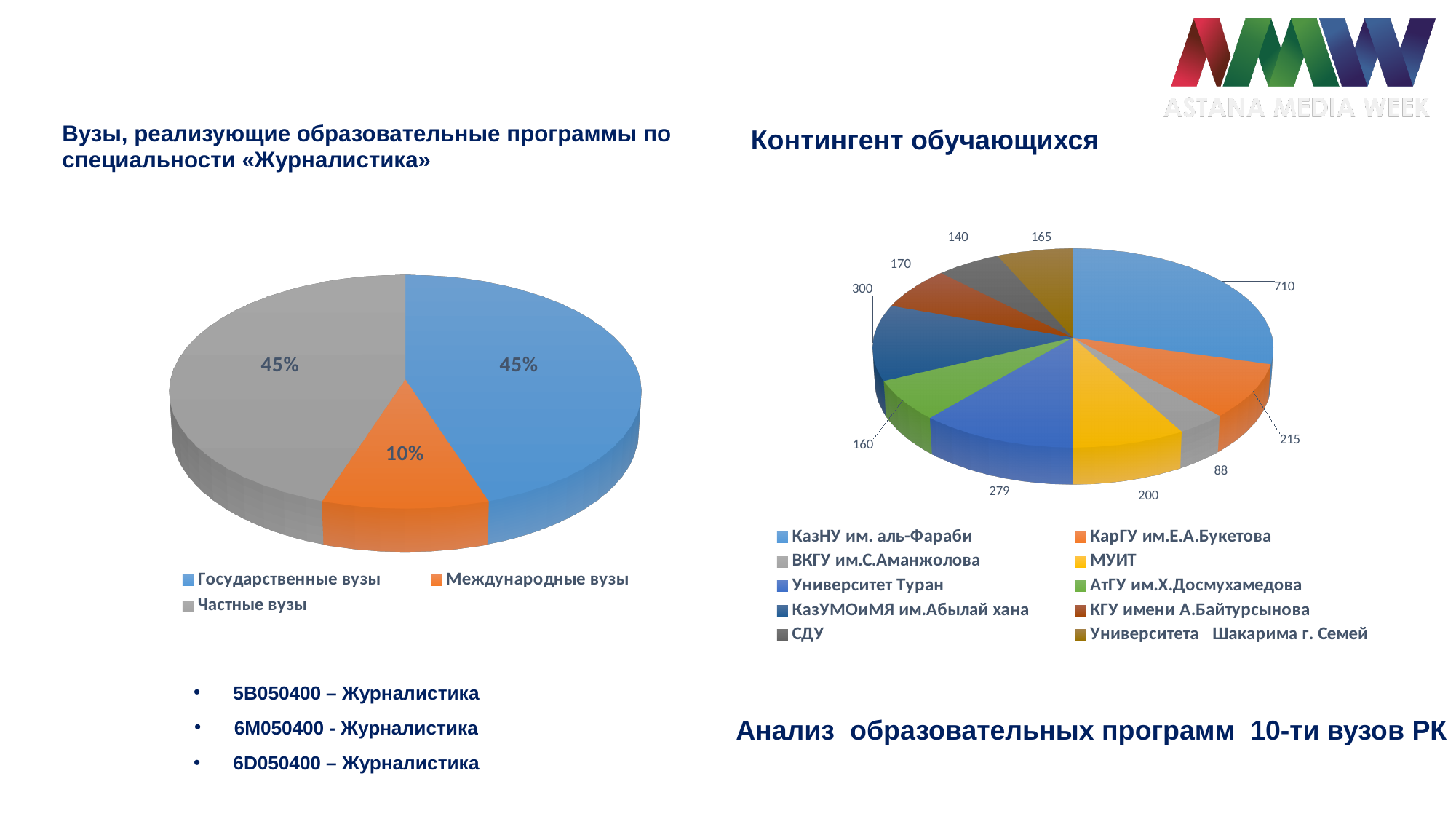
In the left pie chart «Вузы, реализующие образовательные программы по специальности «Журналистика»», what share do Международные вузы have? 10% In the «Контингент обучающихся» chart, what is the difference between КазУМОиМЯ им.Абылай хана and СДУ? 160 In the «Контингент обучающихся» chart, which university has the lowest value? ВКГУ им.С.Аманжолова In the «Контингент обучающихся» chart, which university has the highest value? КазНУ им. аль-Фараби In the «Контингент обучающихся» chart, what is the value for Университет Туран? 279 How many categories does the left pie chart «Вузы, реализующие образовательные программы...» show? 3 In the «Контингент обучающихся» chart, what is the value for КазНУ им. аль-Фараби? 710 In the «Контингент обучающихся» chart, which is larger: КарГУ им.Е.А.Букетова or МУИТ? КарГУ им.Е.А.Букетова What type of chart is the «Контингент обучающихся» chart? Pie chart How many universities does the legend of the «Контингент обучающихся» chart list? 10 In the left pie chart, what share do Государственные вузы have? 45% In the left pie chart, which category has the smallest share? Международные вузы